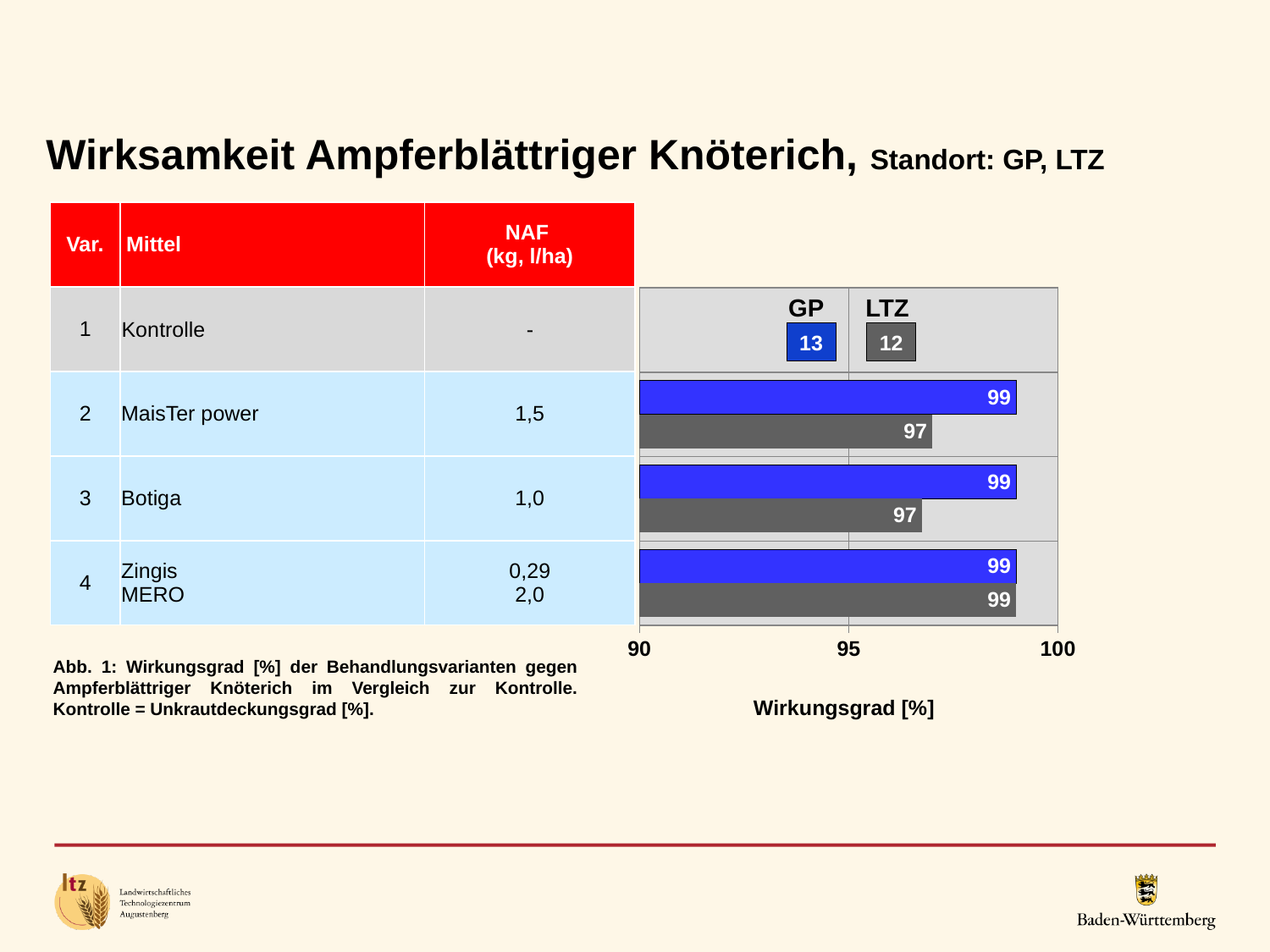
Which treatment has the highest LTZ value? Zingis / MERO What is the LTZ value for Zingis / MERO? 99 What is the label of the x axis? Wirkungsgrad [%] What is the GP value for MaisTer power? 99 What is the LTZ value for Botiga? 97 What value is shown in the legend box for the LTZ control (Kontrolle)? 12 How many series does the chart legend list? 2 For Botiga, which is larger, the GP value or the LTZ value? GP What value is shown in the legend box for the GP control (Kontrolle)? 13 What kind of chart is shown on the slide? bar chart What is the difference between the GP and LTZ values for MaisTer power? 2 Which colour represents the GP series in the chart? blue